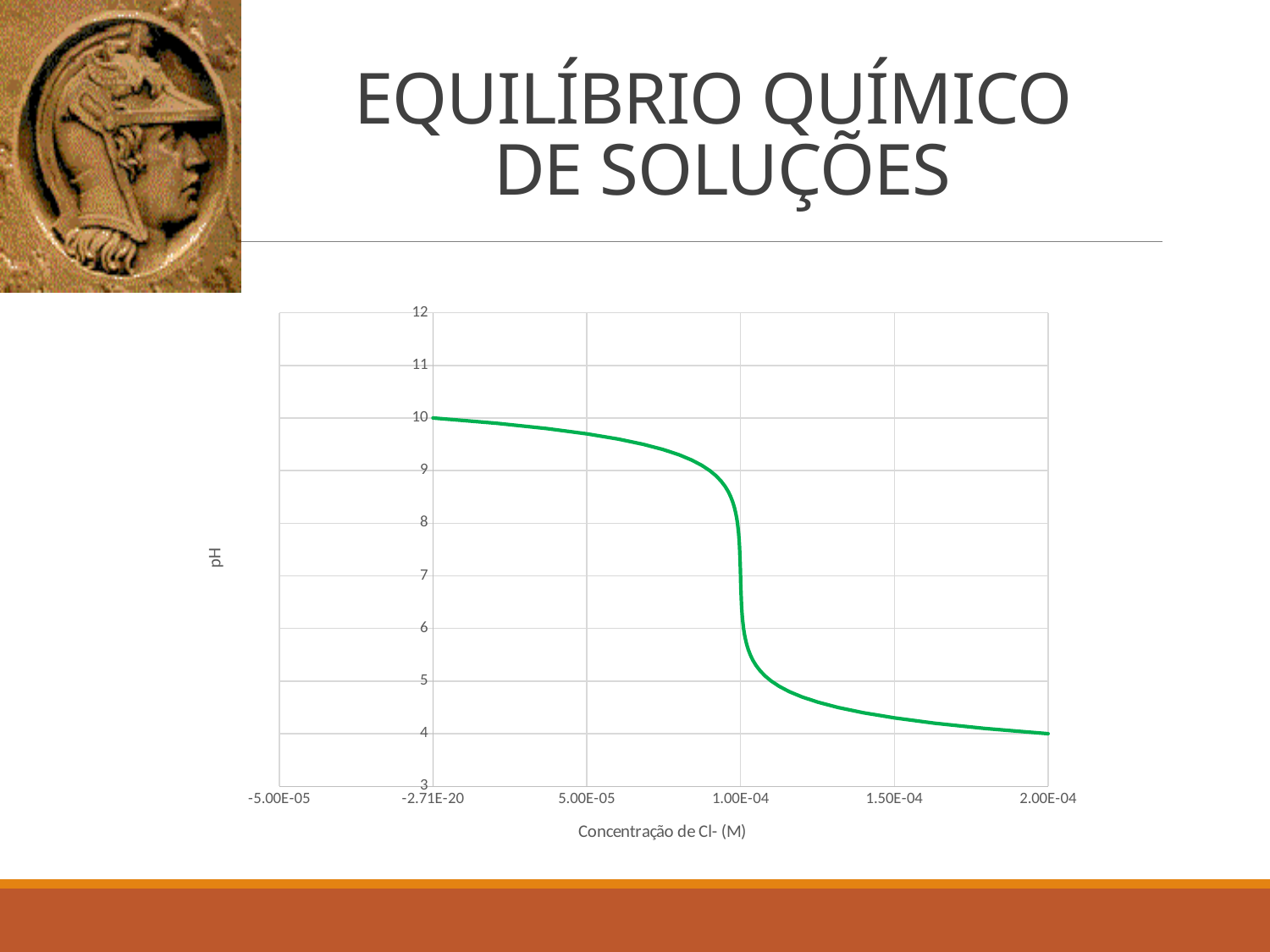
What is the pH value at the right end of the curve, at a concentration of 2.00E-04 M? 4 Is the pH at a Cl- concentration of 1.50E-04 M greater or less than 4? greater What kind of chart is shown on the slide? line chart Does the pH rise or fall as the concentration of Cl- increases along the x axis? fall Which has the higher pH: the point at 5.00E-05 M or the point at 1.50E-04 M? 5.00E-05 M Is the pH at a Cl- concentration of 1.50E-04 M greater or less than 5? less What is the label of the y axis of the chart? pH Around which Cl- concentration on the x axis does the curve drop most steeply? 1.00E-04 What is the label of the x axis of the chart? Concentração de Cl- (M) What is the pH value at the left end of the curve, at the lowest concentration plotted? 10 Is the pH at a Cl- concentration of 5.00E-05 M greater or less than 9? greater